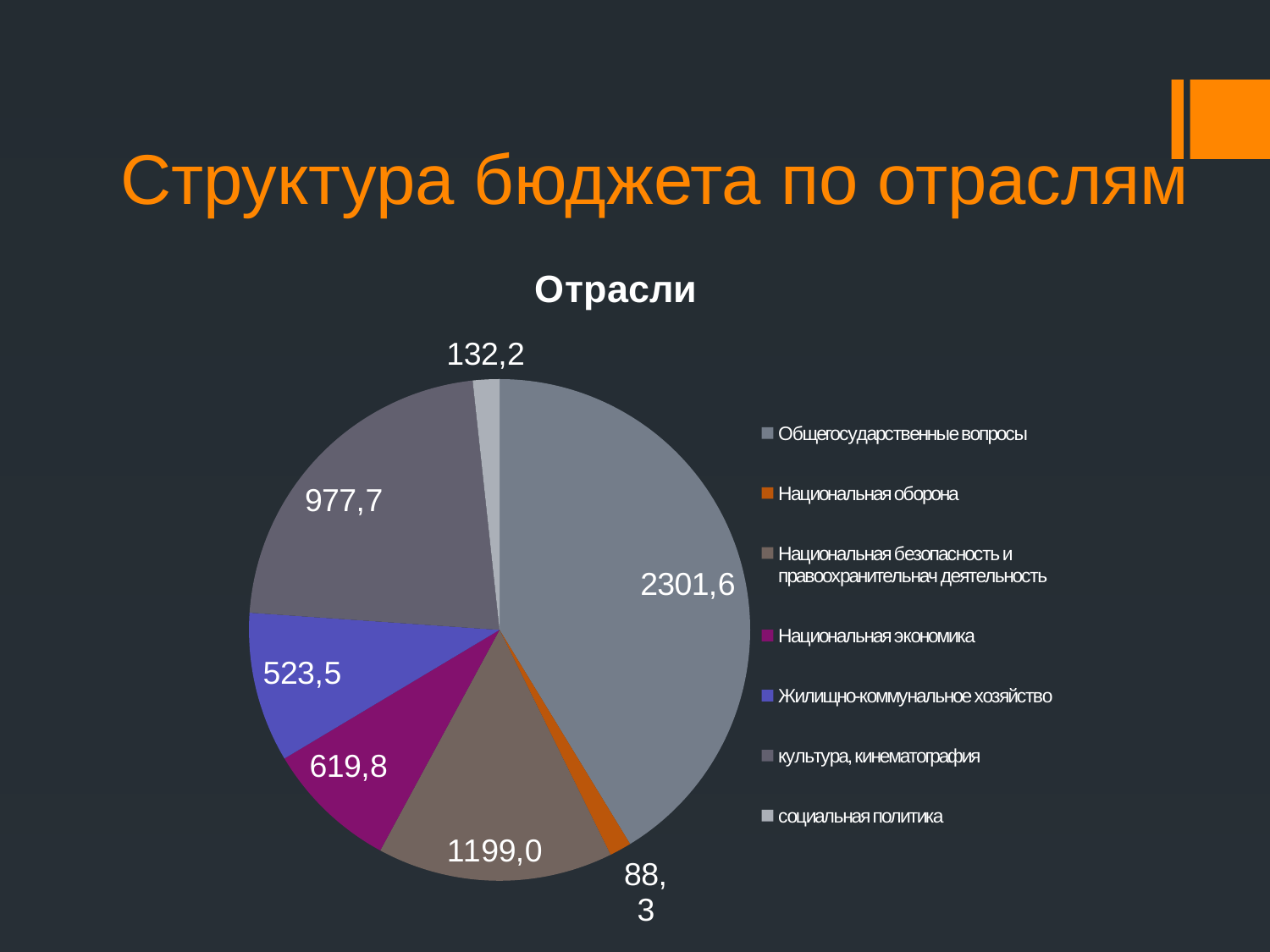
Which category has the smallest slice? Национальная оборона What is the value for Жилищно-коммунальное хозяйство? 523,5 What kind of chart is shown on the slide? pie chart Which is larger, Национальная экономика or Жилищно-коммунальное хозяйство? Национальная экономика What is the value for Национальная оборона? 88,3 What is the value for культура, кинематография? 977,7 How many slices does the pie chart have? 7 What is the value for Общегосударственные вопросы? 2301,6 What is the difference between Общегосударственные вопросы and Национальная безопасность и правоохранительная деятельность? 1102,6 What is the title of the chart? Отрасли Which category has the largest slice? Общегосударственные вопросы What colour is the slice for Национальная оборона? orange